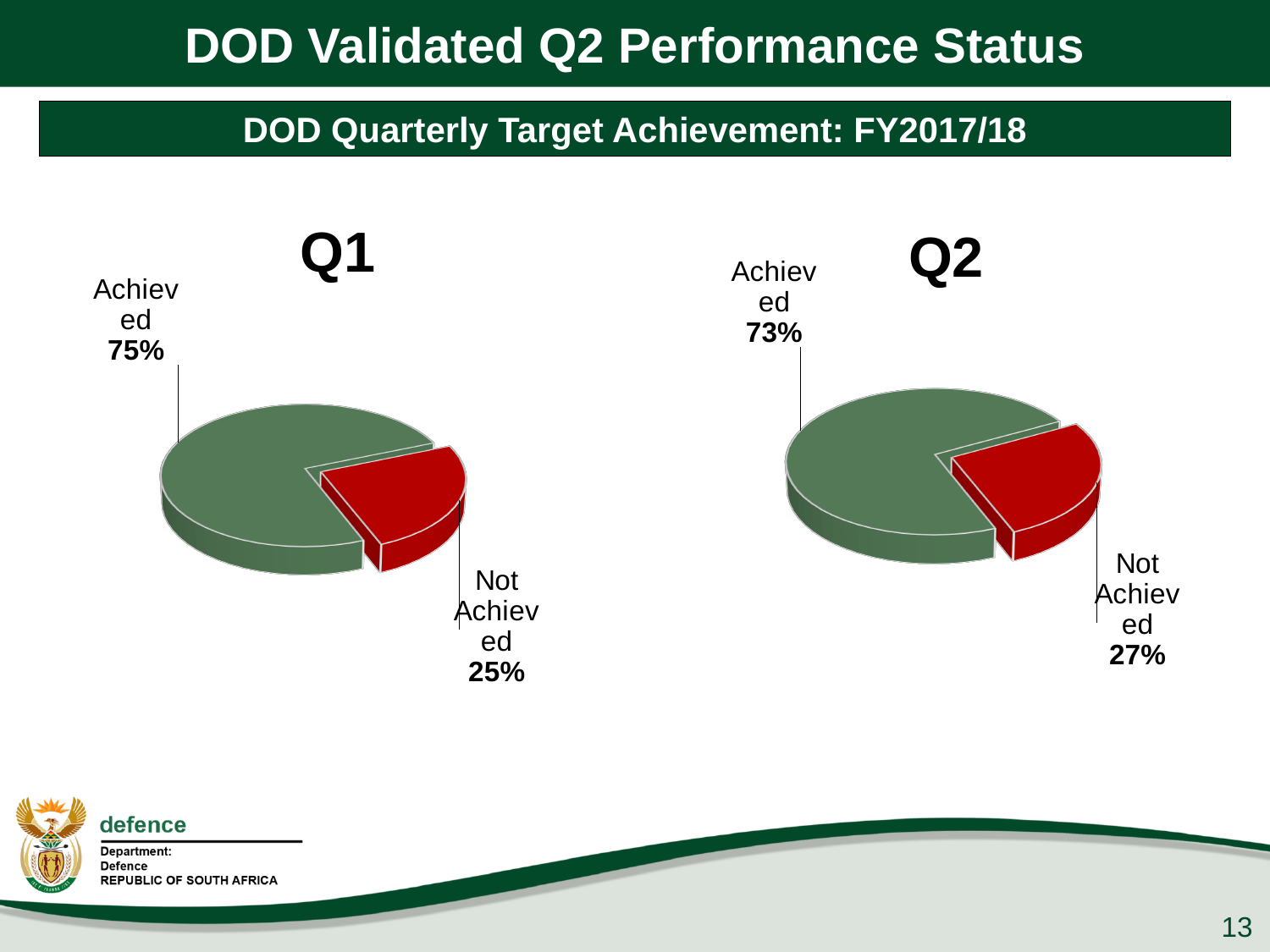
In the Q1 pie chart, what percentage of targets was Achieved? 75% In the Q1 pie chart, which slice is the largest? Achieved In the Q2 pie chart, which slice is the smallest? Not Achieved In the Q2 pie chart, what percentage of targets was Not Achieved? 27% What type of chart is used for Q1 and Q2? Pie chart How many slices does the Q2 pie chart have? 2 In the Q2 pie chart, what percentage of targets was Achieved? 73% Is the Achieved share larger in the Q1 chart or the Q2 chart? Q1 In the Q1 pie chart, what percentage of targets was Not Achieved? 25% What is the difference between the Achieved percentage in Q1 and the Achieved percentage in Q2? 2% What colour is the Not Achieved slice in the Q2 pie chart? Red In the Q1 pie chart, what is the difference between the Achieved and Not Achieved percentages? 50%